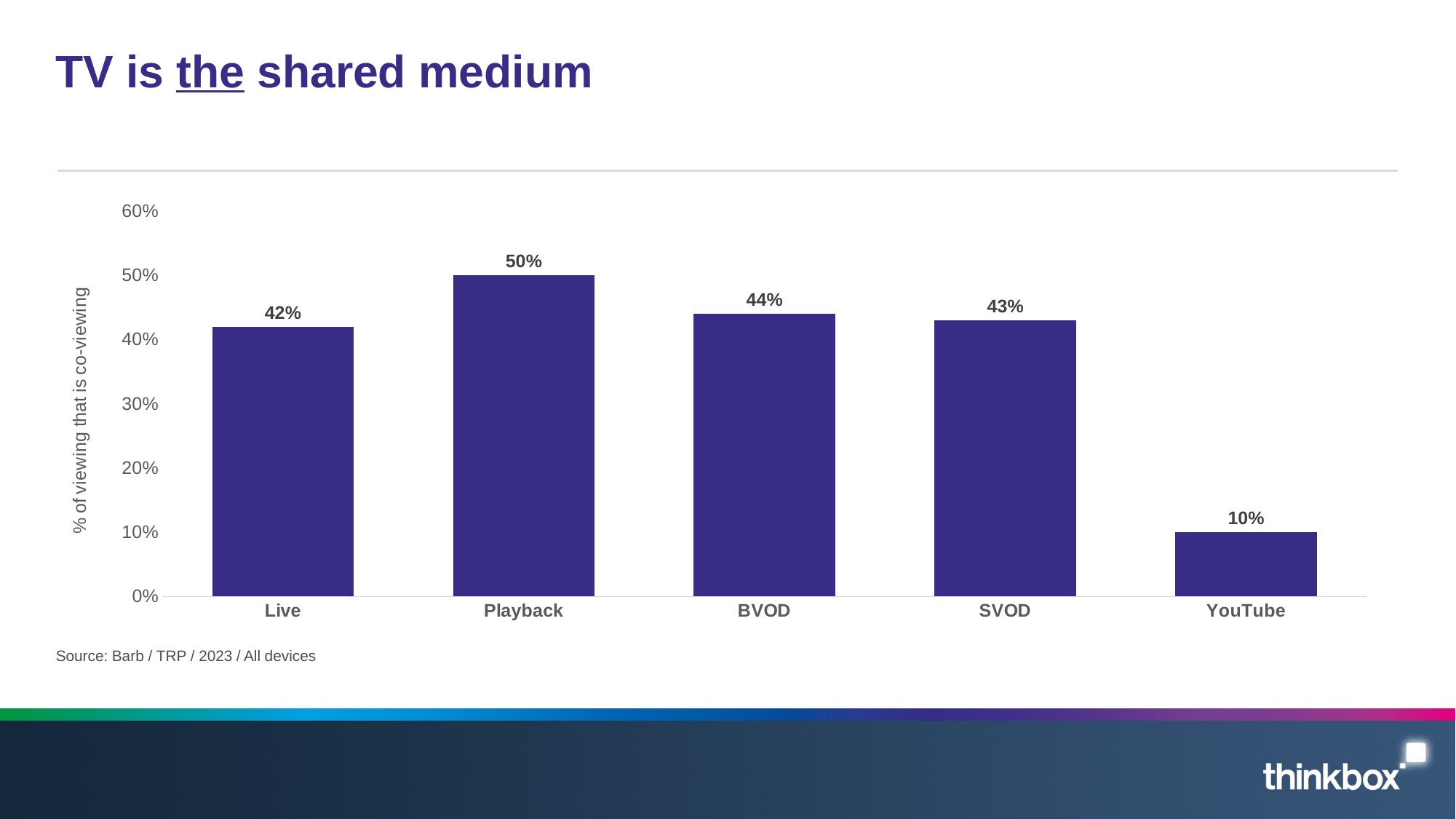
What is the value for Playback? 50% What is the label of the vertical axis? % of viewing that is co-viewing How many categories are shown on the x axis? 5 What is the difference between the values for BVOD and Live? 2% Which category has the highest value? Playback What is the value for BVOD? 44% What is the value for YouTube? 10% What kind of chart is shown on the slide? Bar chart What is the value for Live? 42% What is the difference between the values for Playback and YouTube? 40% Which is larger, the value for Live or the value for Playback? Playback Which category has the lowest value? YouTube